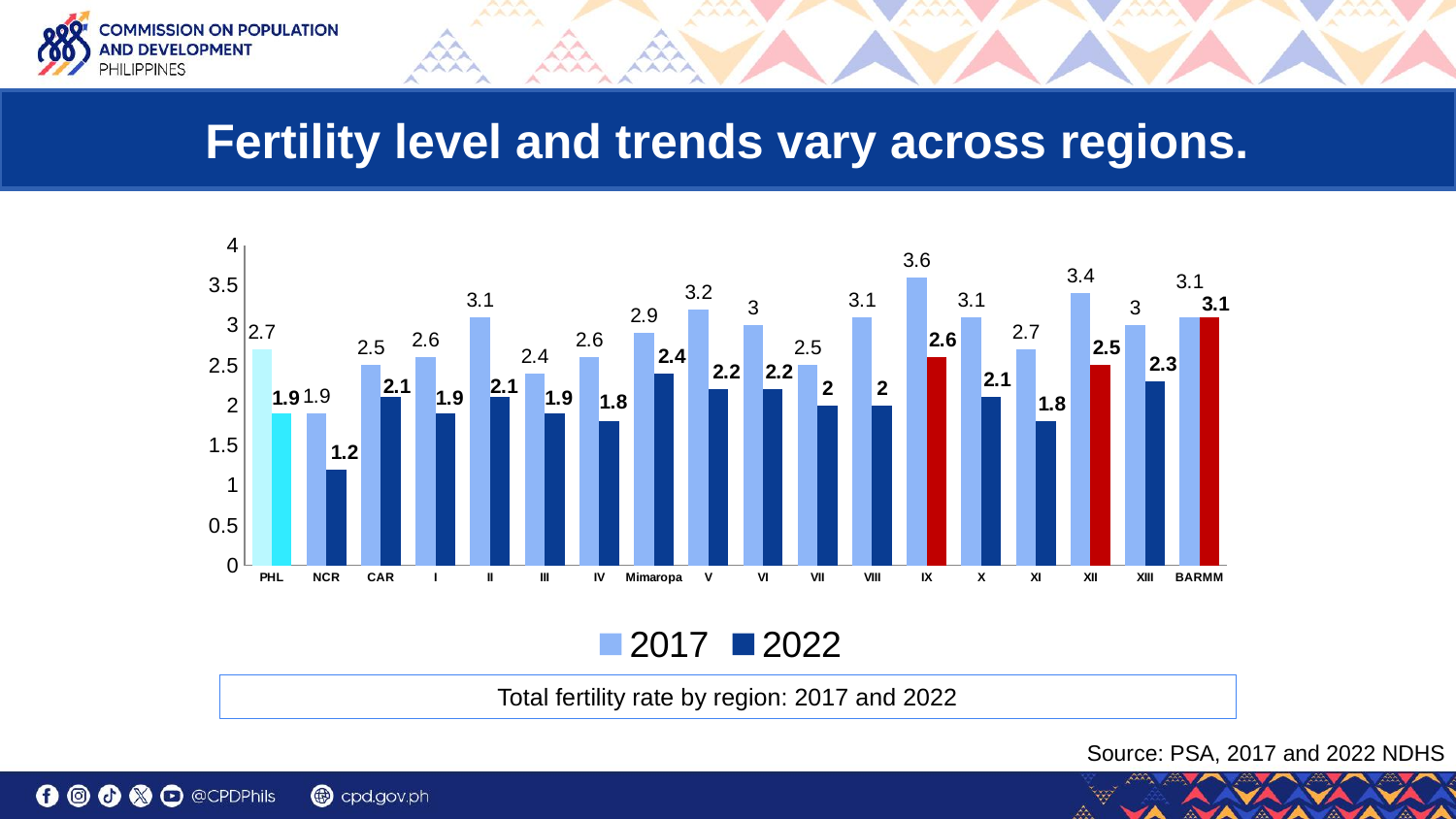
What is the 2022 total fertility rate for BARMM? 3.1 Which is larger, the 2022 total fertility rate for Mimaropa or for Region VII? Mimaropa What is the difference between the 2017 and 2022 total fertility rates for Region IX? 1 Which region has the highest 2022 total fertility rate? BARMM How many series does the legend list? 2 How many regions (categories) are shown on the x axis? 18 What is the difference between the 2017 and 2022 total fertility rates for PHL? 0.8 Which region has the highest 2017 total fertility rate? IX What kind of chart is shown on the slide? Bar chart What is the 2022 total fertility rate for NCR? 1.2 Which region has the lowest 2022 total fertility rate? NCR What is the 2017 total fertility rate for Region IX? 3.6